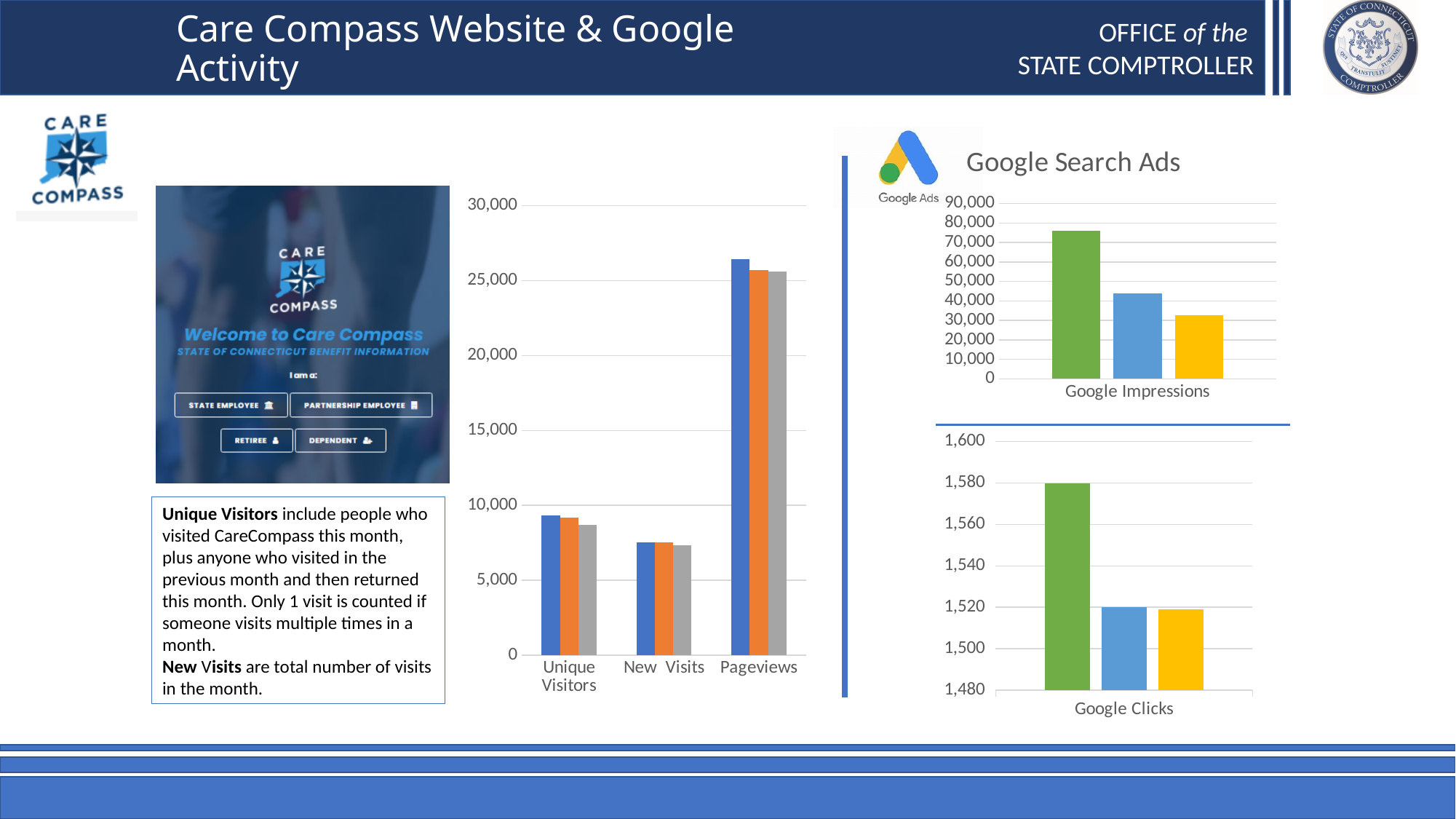
In the website activity chart in the middle of the slide, which category has the lowest values? New Visits In the Google Clicks chart, is the green bar greater or less than 1,560? greater In the Google Impressions chart, which bar is the tallest? the green bar In the Google Impressions chart, is the green bar greater or less than 70,000? greater In the website activity chart in the middle of the slide, is the blue bar for New Visits greater or less than 5,000? greater How many bars are shown in the Google Clicks chart? 3 In the website activity chart in the middle of the slide, which category has the highest values? Pageviews What kind of chart is the website activity chart in the middle of the slide? bar chart How many categories are shown on the x axis of the website activity chart in the middle of the slide? 3